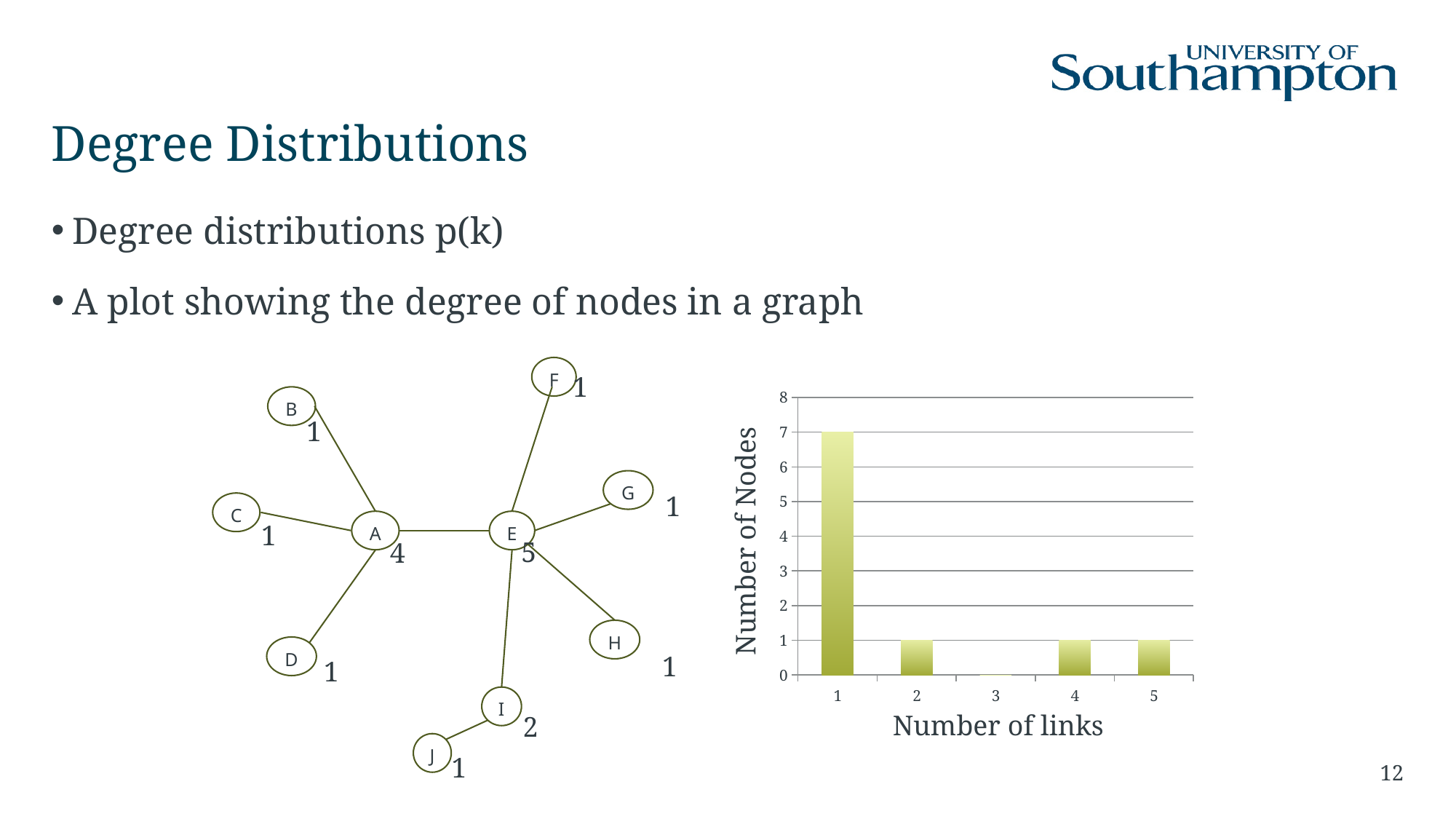
What is the difference between the number of nodes with 1 link and the number of nodes with 4 links? 6 How many categories are shown on the x axis of the bar chart? 5 What is the number of nodes with 5 links in the bar chart? 1 Which has more nodes in the bar chart: 1 link or 4 links? 1 link What is the number of nodes with 2 links in the bar chart? 1 Which number of links has the highest number of nodes in the bar chart? 1 What is the number of nodes with 1 link in the bar chart? 7 Is the number of nodes with 1 link greater or less than 5? greater Which number of links on the x axis has no bar (zero nodes) in the bar chart? 3 What kind of chart is shown on the right of the slide? bar chart Does the number of nodes rise or fall from 1 link to 2 links in the bar chart? fall What is the title of the y axis of the bar chart? Number of Nodes